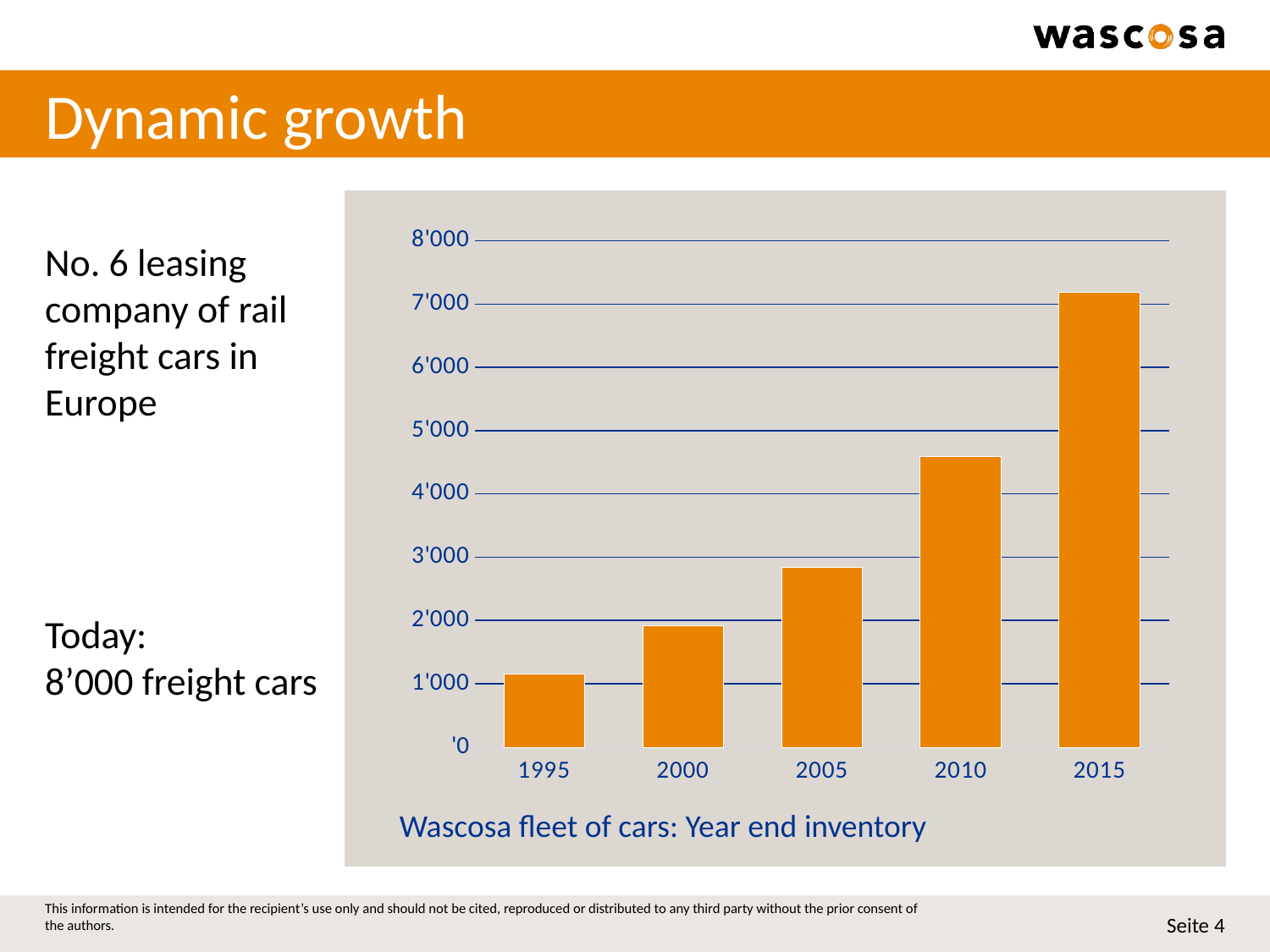
How many years are plotted on the x axis of the chart? 5 What is the caption shown below the chart? Wascosa fleet of cars: Year end inventory Which year has the lowest bar in the chart? 1995 Which year has the highest bar in the chart? 2015 Is the value for 1995 greater or less than 2'000? less Is the value for 2015 greater or less than 6'000? greater Do the values rise or fall from 1995 to 2015? Rise Which year has the larger value, 2005 or 2010? 2010 What kind of chart is shown on the slide? Bar chart Is the value for 2005 greater or less than 2'000? greater